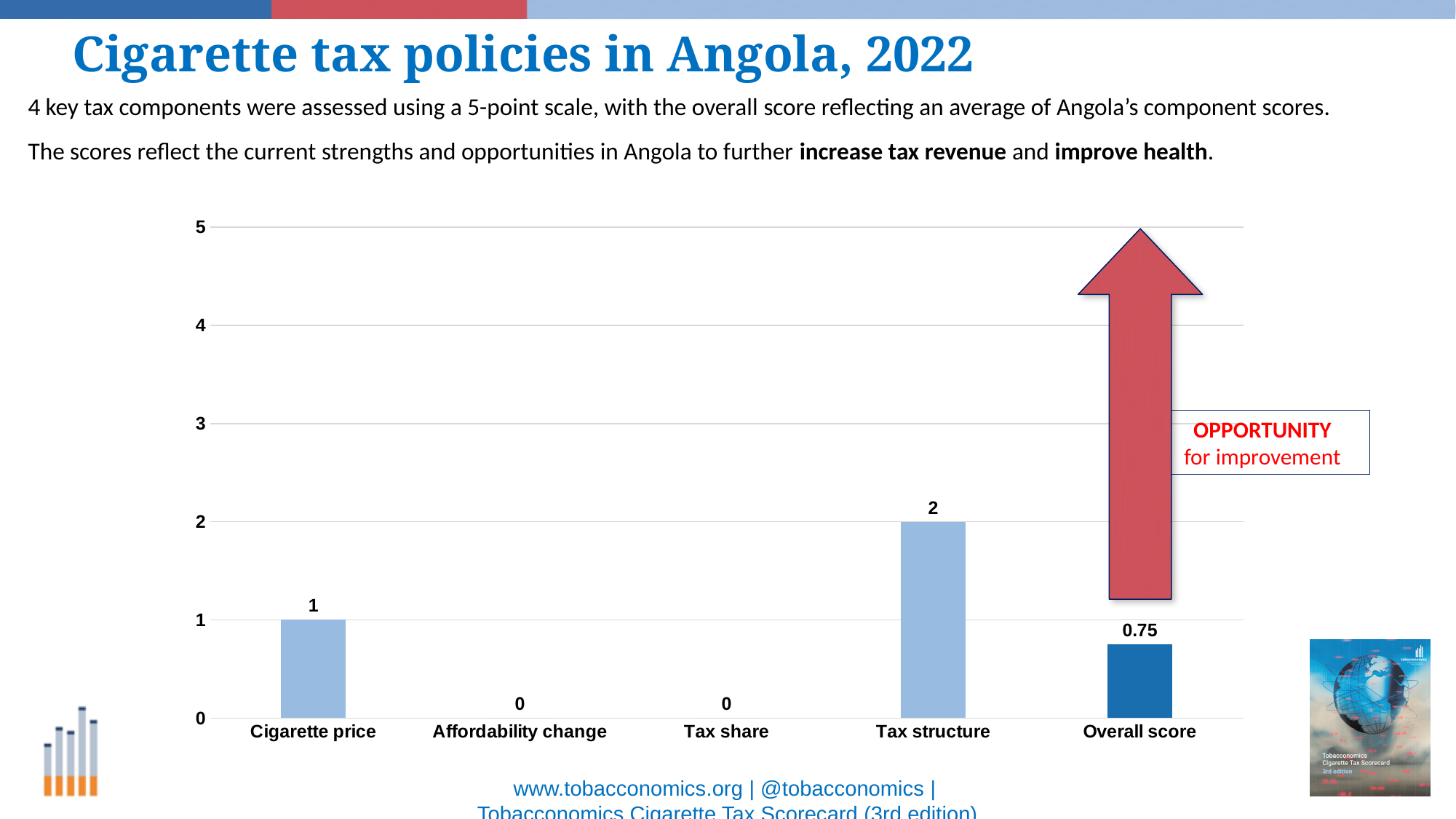
Is the Overall score greater or less than 1? less Which category has the highest score? Tax structure What is the score for Affordability change? 0 What is the score for Tax structure? 2 What is the maximum value shown on the y axis? 5 What is the Overall score? 0.75 How many categories have a score of 0? 2 How many categories are shown on the x axis? 5 What is the score for Cigarette price? 1 Which is larger, the score for Cigarette price or the Overall score? Cigarette price What kind of chart is shown on the slide? bar chart What is the difference between the Tax structure score and the Cigarette price score? 1